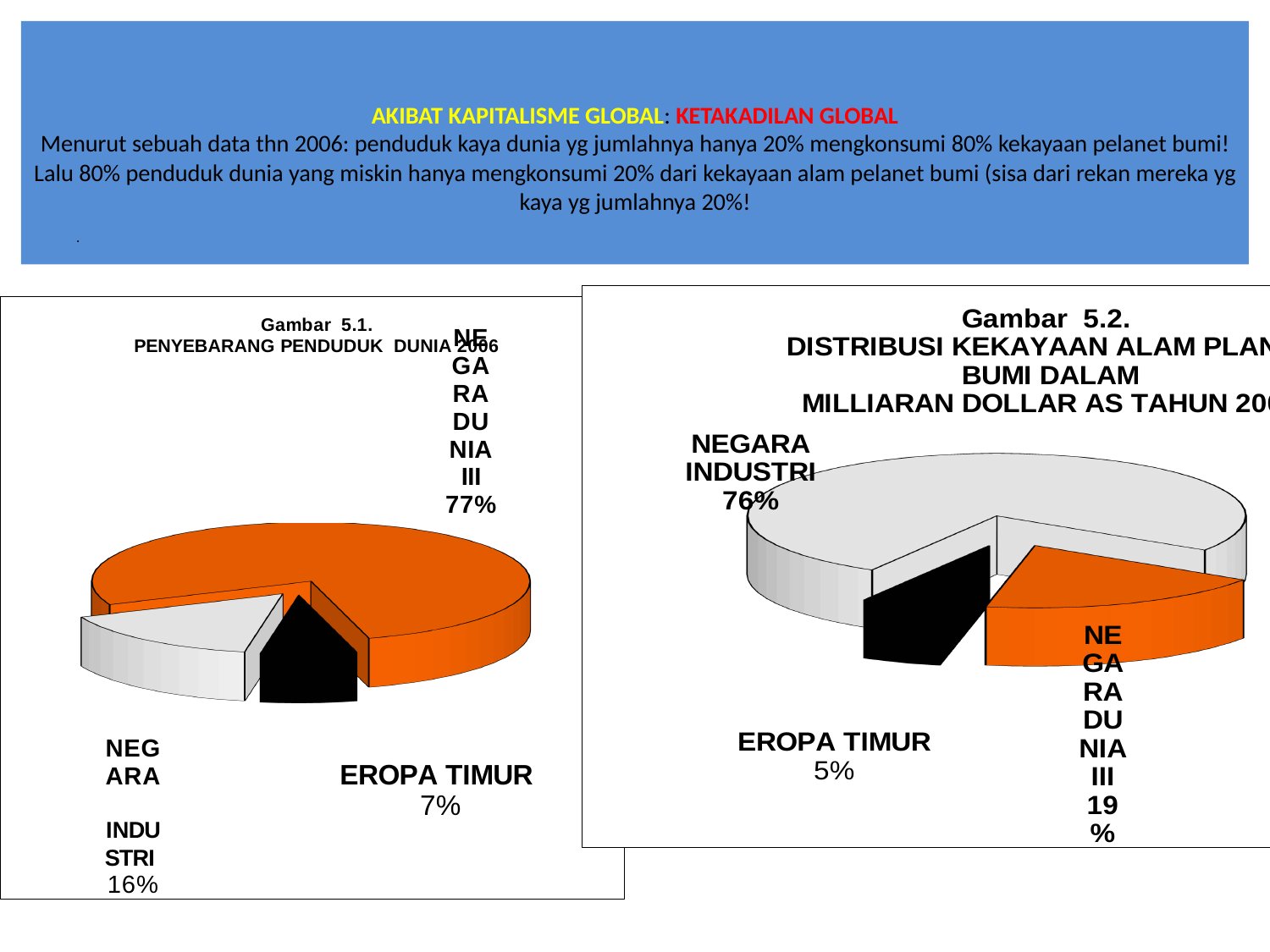
In the right chart (Gambar 5.2), which is larger: the NEGARA DUNIA III slice or the EROPA TIMUR slice? NEGARA DUNIA III In the right chart (Gambar 5.2), which category has the smallest slice? EROPA TIMUR What type of chart is the left chart (Gambar 5.1)? Pie chart In the left chart (Gambar 5.1), what is the value for EROPA TIMUR? 7% In the left chart (Gambar 5.1), what is the value for NEGARA INDUSTRI? 16% In the right chart (Gambar 5.2), what is the value for NEGARA DUNIA III? 19% In the right chart (Gambar 5.2), what share is labelled for NEGARA INDUSTRI? 76% How many slices does the right chart (Gambar 5.2) have? 3 In the left chart (Gambar 5.1), what is the difference between the NEGARA DUNIA III share and the NEGARA INDUSTRI share? 61% In the left chart (Gambar 5.1), which category has the largest slice? NEGARA DUNIA III In the left chart (Gambar 5.1), what share of the world population is in NEGARA DUNIA III? 77% In the right chart (Gambar 5.2), what is the value for EROPA TIMUR? 5%